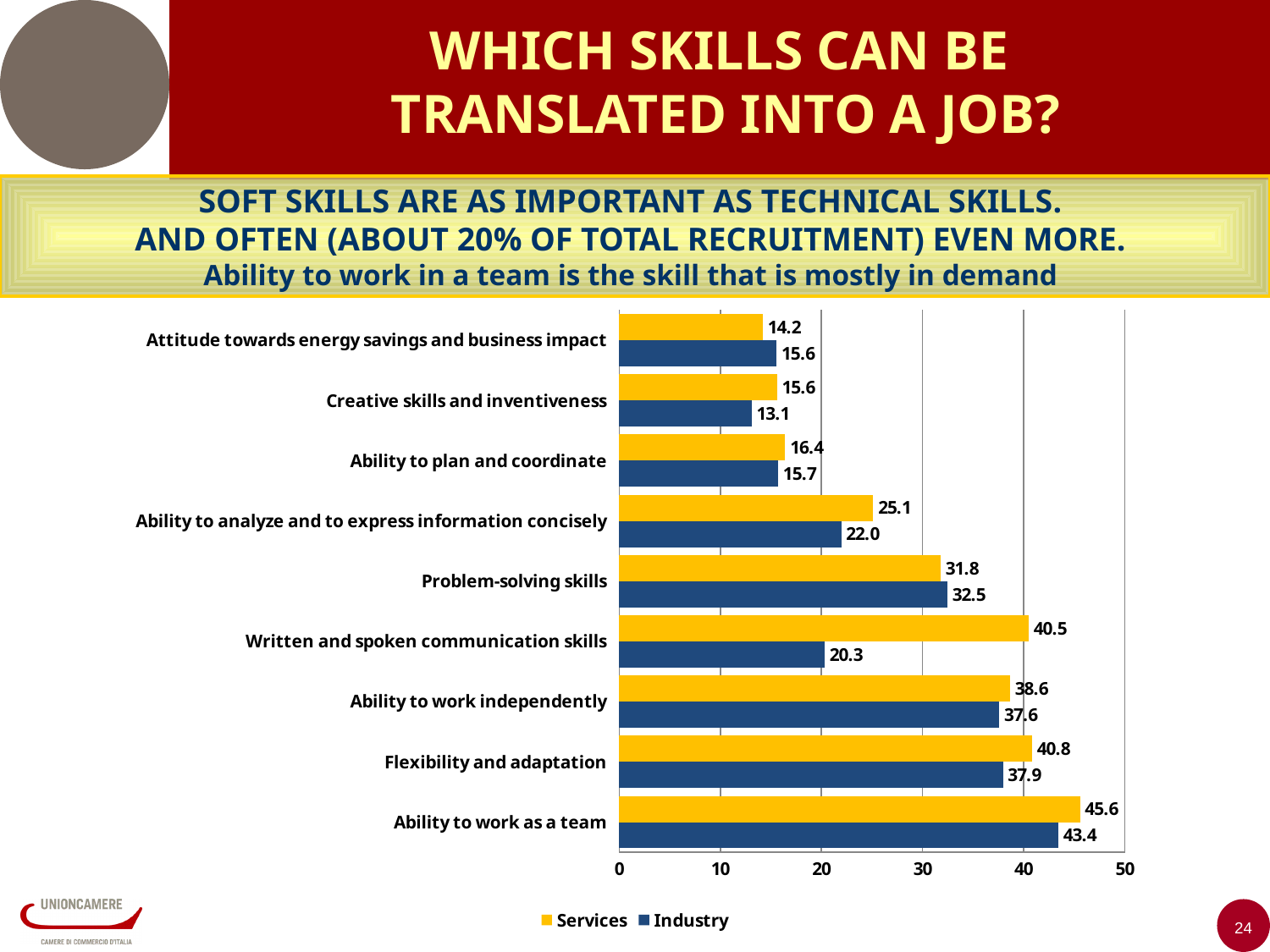
Which skill has the highest Services value? Ability to work as a team What is the difference between the Services and Industry values for Written and spoken communication skills? 20.2 Which skill has the lowest Industry value? Creative skills and inventiveness Is the Services value for Flexibility and adaptation greater or less than 40? greater What is the Industry value for Written and spoken communication skills? 20.3 What type of chart is shown on the slide? Bar chart How many series does the legend list? 2 What is the Industry value for Creative skills and inventiveness? 13.1 What is the Services value for Ability to work as a team? 45.6 How many skill categories are shown in the chart? 9 Which colour represents the Services series in the chart? Yellow For Problem-solving skills, which series has the larger value, Services or Industry? Industry